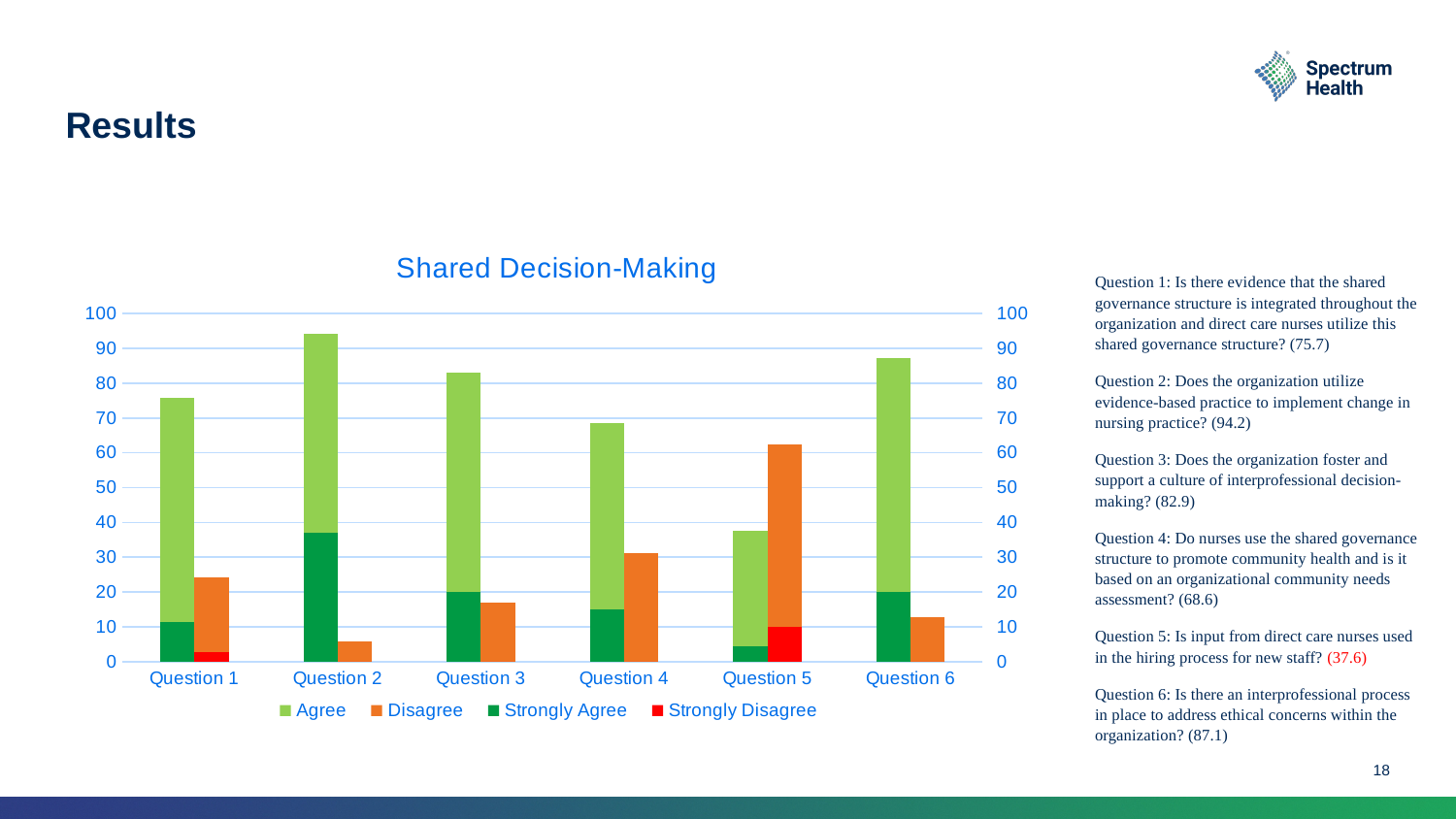
What kind of chart is shown on the slide? Bar chart Which is larger, the Disagree bar for Question 4 or the Disagree bar for Question 3? Question 4 Is the Disagree bar for Question 2 greater or less than 10? less How many questions (categories) are shown on the x axis of the chart? 6 Is the stacked Disagree/Strongly Disagree bar for Question 5 greater or less than 50? greater Is the stacked Agree/Strongly Agree bar for Question 1 greater or less than 70? greater Which question has the shortest stacked Agree/Strongly Agree bar? Question 5 What colour represents Strongly Disagree in the chart legend? Red What is the title of the chart? Shared Decision-Making Which question has the tallest stacked Agree/Strongly Agree bar? Question 2 How many series does the chart legend list? 4 Which question has the largest Strongly Agree segment? Question 2